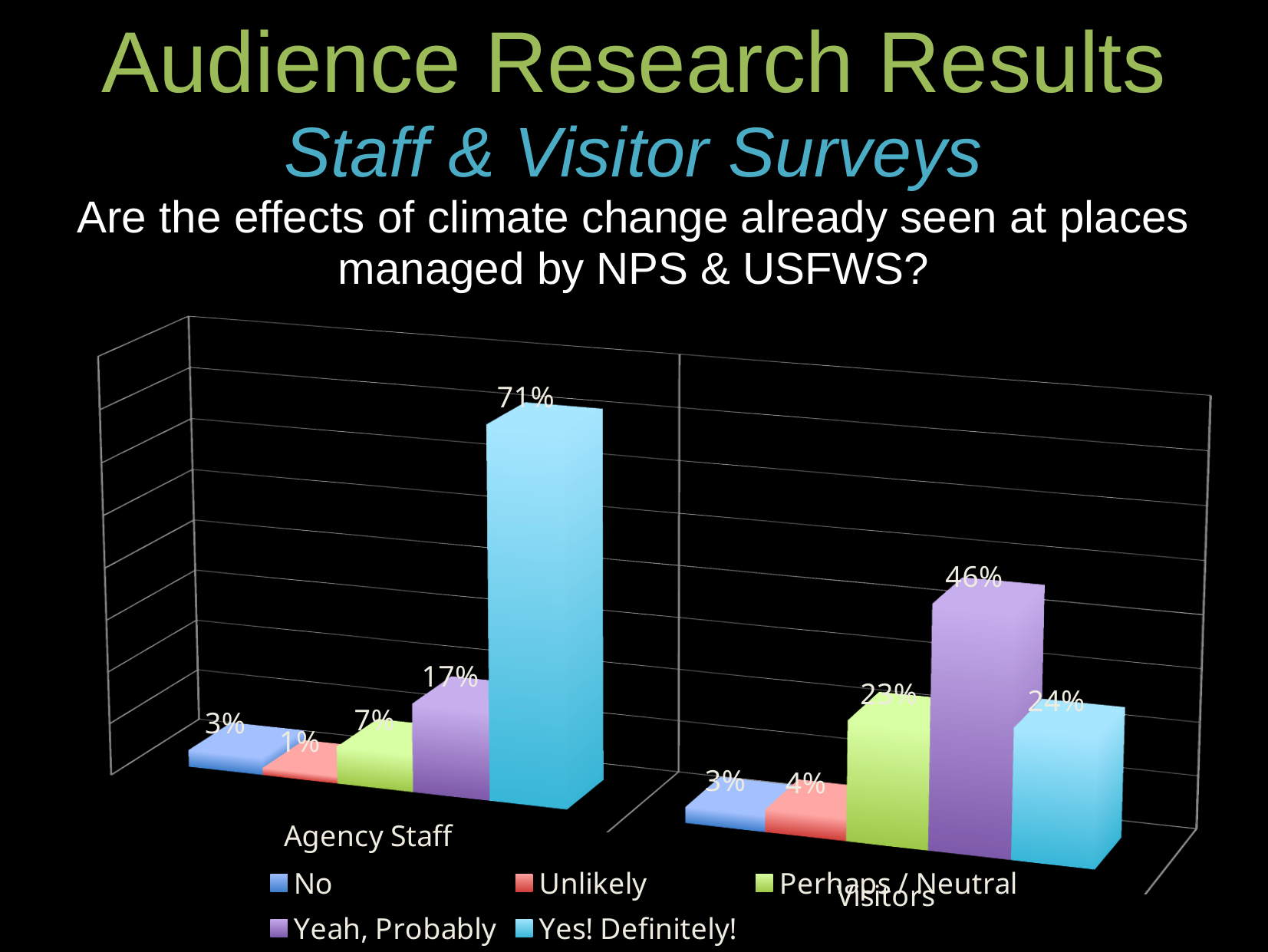
What percentage of Visitors answered "Yeah, Probably"? 46% Which response was least common among Agency Staff? Unlikely How many response options does the legend list? 5 What type of chart is shown on the slide? Bar chart What percentage of Agency Staff answered "Unlikely"? 1% What percentage of Visitors answered "Perhaps / Neutral"? 23% What is the difference between the "Yes! Definitely!" percentages for Agency Staff and Visitors? 47% Which group had a higher percentage answering "Perhaps / Neutral", Agency Staff or Visitors? Visitors Which response was most common among Visitors? Yeah, Probably How many respondent groups are shown on the x axis? 2 What percentage of Agency Staff answered "Yes! Definitely!"? 71% Which response was most common among Agency Staff? Yes! Definitely!